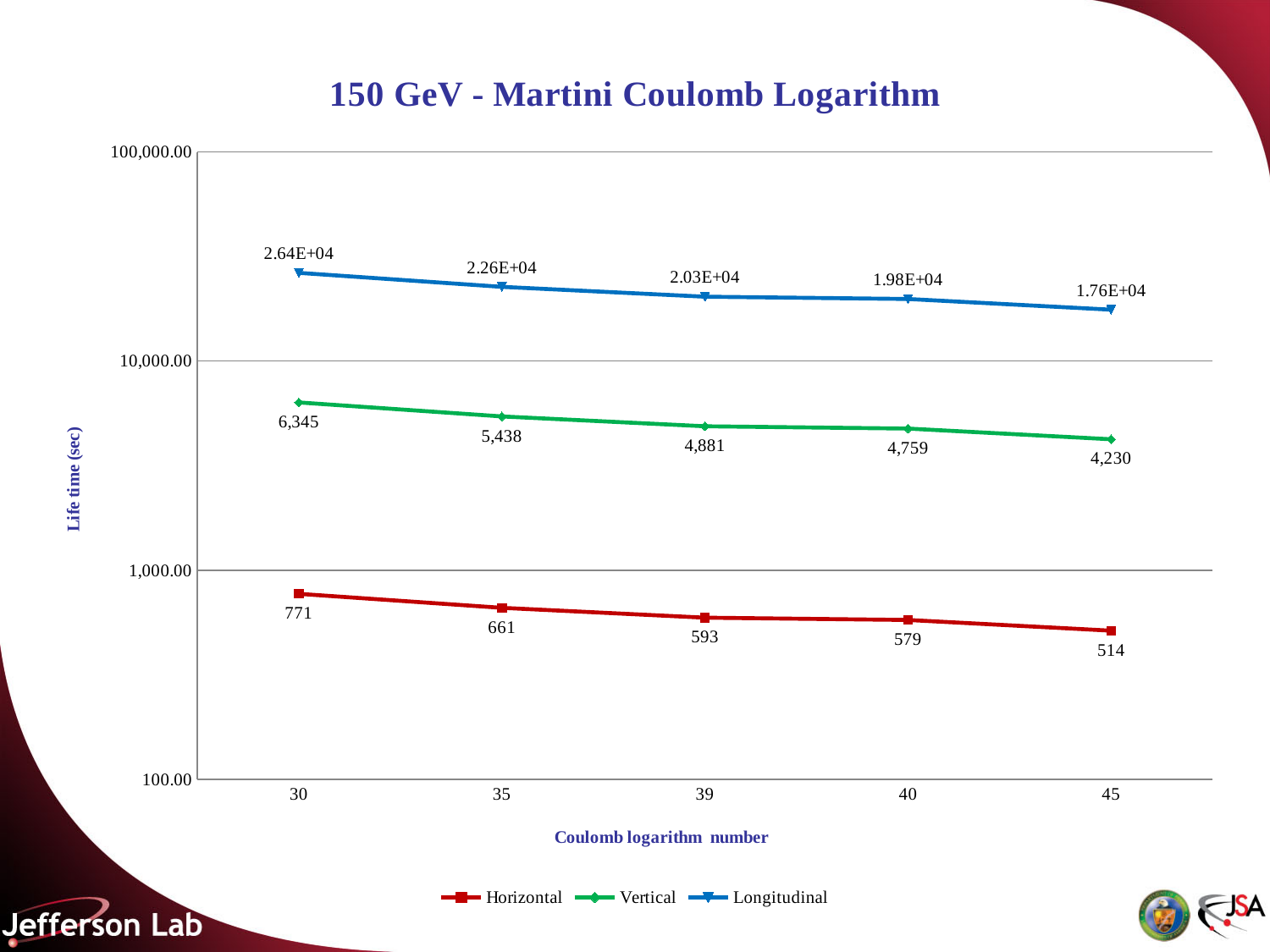
What kind of chart is shown on the slide? Line chart Which is larger, the Vertical life time at 40 or the Horizontal life time at 40? Vertical What is the Vertical life time at Coulomb logarithm number 39? 4,881 What is the difference between the Vertical life time at 35 and at 40? 679 What is the difference between the Horizontal life time at 30 and at 45? 257 Do the Longitudinal life time values rise or fall as the Coulomb logarithm number increases? Fall What is the Longitudinal life time at Coulomb logarithm number 45? 1.76E+04 At which Coulomb logarithm number is the Horizontal life time lowest? 45 How many series does the legend list? 3 At which Coulomb logarithm number is the Vertical life time highest? 30 What is the Horizontal life time at Coulomb logarithm number 30? 771 How many Coulomb logarithm numbers are plotted on the x axis? 5